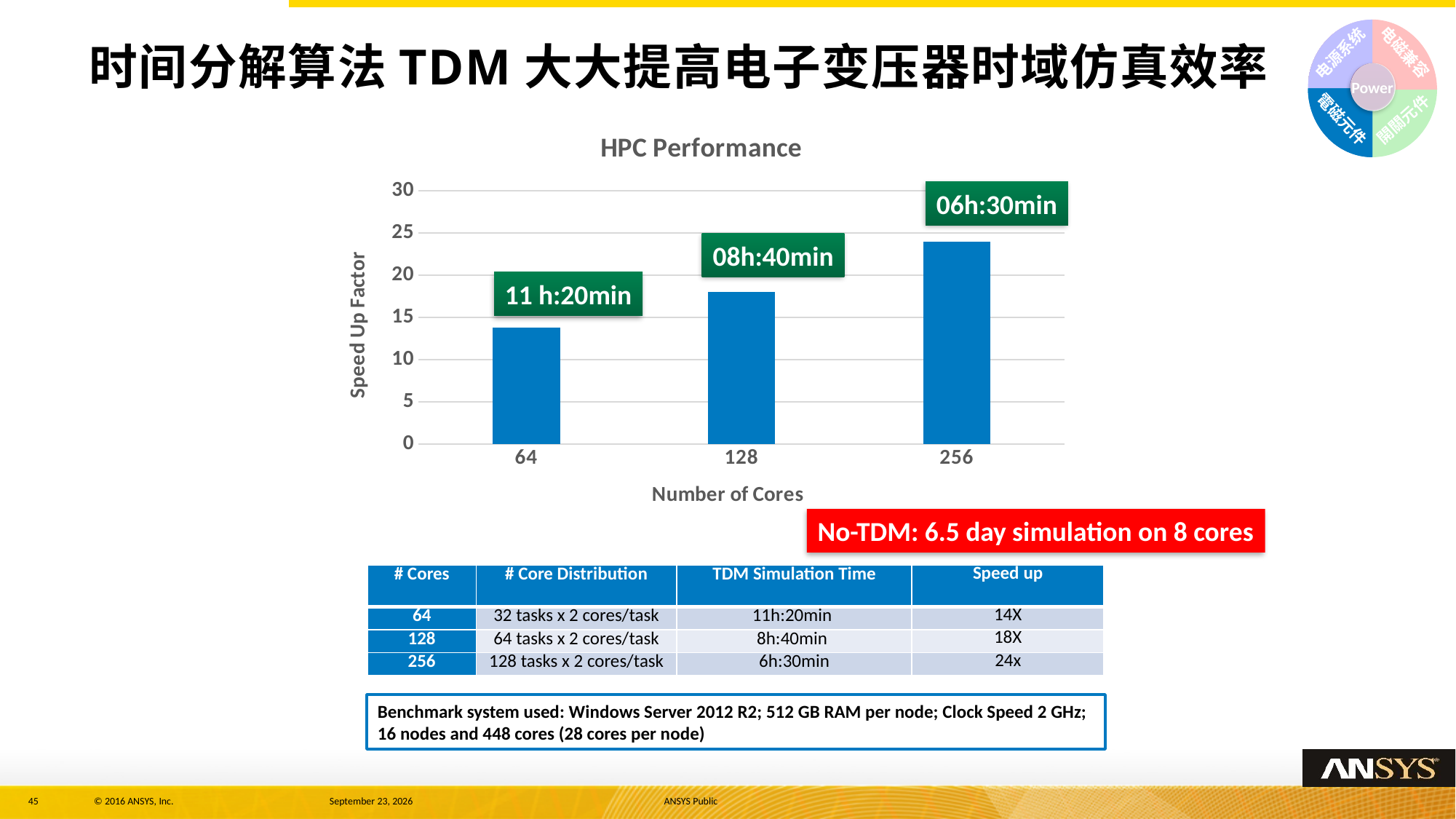
Is the speed up factor for 128 cores greater or less than 20? less What is the title of the x axis in the HPC Performance chart? Number of Cores What time label is shown above the bar for 64 cores in the HPC Performance chart? 11 h:20min What time label is shown above the bar for 256 cores in the HPC Performance chart? 06h:30min Is the speed up factor for 256 cores greater or less than 20? greater Do the speed up factors rise or fall as the number of cores increases along the x axis? rise What time label is shown above the bar for 128 cores in the HPC Performance chart? 08h:40min Is the speed up factor for 64 cores greater or less than 10? greater How many bars (core counts) are plotted in the HPC Performance chart? 3 Which number of cores has the lowest speed up factor in the HPC Performance chart? 64 What kind of chart is shown under the title "HPC Performance"? bar chart Which number of cores has the highest speed up factor in the HPC Performance chart? 256